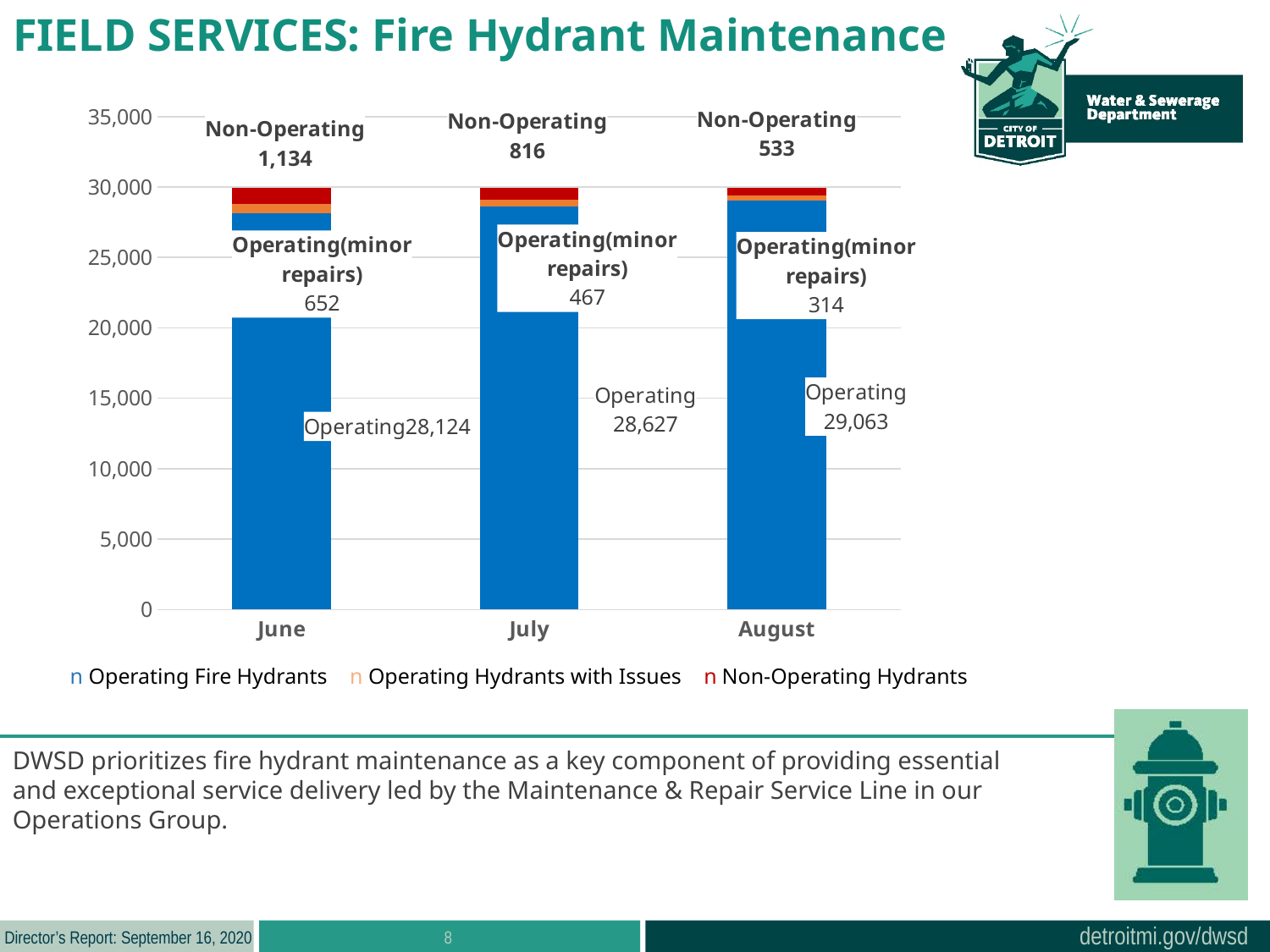
What is the number of Operating (minor repairs) hydrants in August? 314 What is the difference between the Operating hydrant counts in August and June? 939 What is the total of the stacked bar for July? 29,910 What kind of chart is shown on the slide? Stacked bar chart What is the number of Non-Operating hydrants in July? 816 What is the number of Operating fire hydrants in June? 28,124 Which month has the highest number of Non-Operating hydrants? June How many months are shown on the x axis of the chart? 3 How many series does the legend list? 3 Which is larger, the Non-Operating count in June or in August? June Which month has the lowest number of Operating (minor repairs) hydrants? August Do the Operating fire hydrant values rise or fall from June to August? Rise